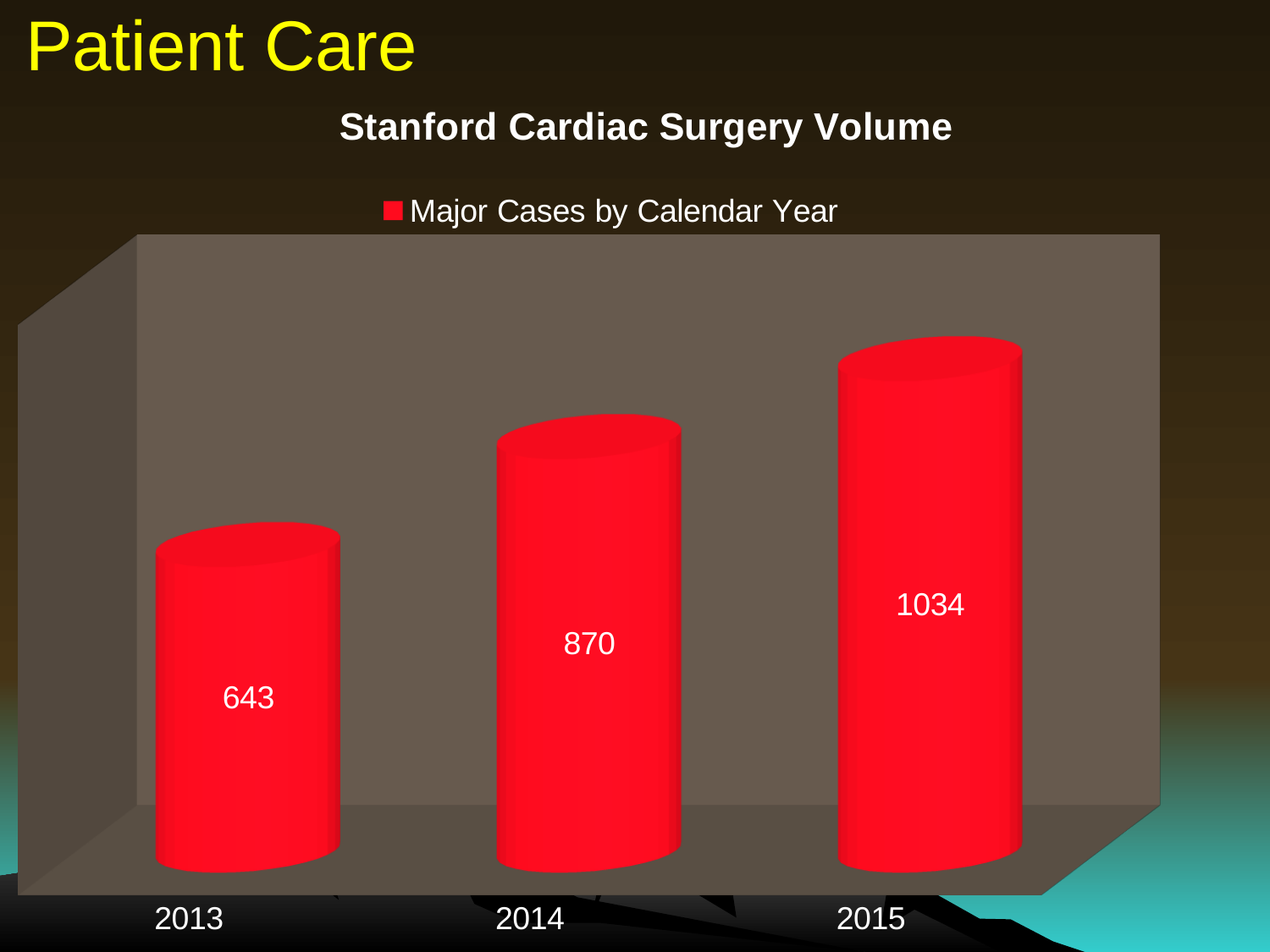
What kind of chart is shown on the slide? Bar chart What is the value for 2014 in the Stanford Cardiac Surgery Volume chart? 870 How many series does the legend list? 1 How many years are shown on the x axis of the chart? 3 What is the difference between the values for 2015 and 2014? 164 What is the value for 2015 in the Stanford Cardiac Surgery Volume chart? 1034 Which year has the highest number of major cases? 2015 What is the value for 2013 in the Stanford Cardiac Surgery Volume chart? 643 Which year has a larger value, 2013 or 2014? 2014 Which year has the lowest number of major cases? 2013 Do the values rise or fall from 2013 to 2015? Rise What is the difference between the values for 2014 and 2013? 227